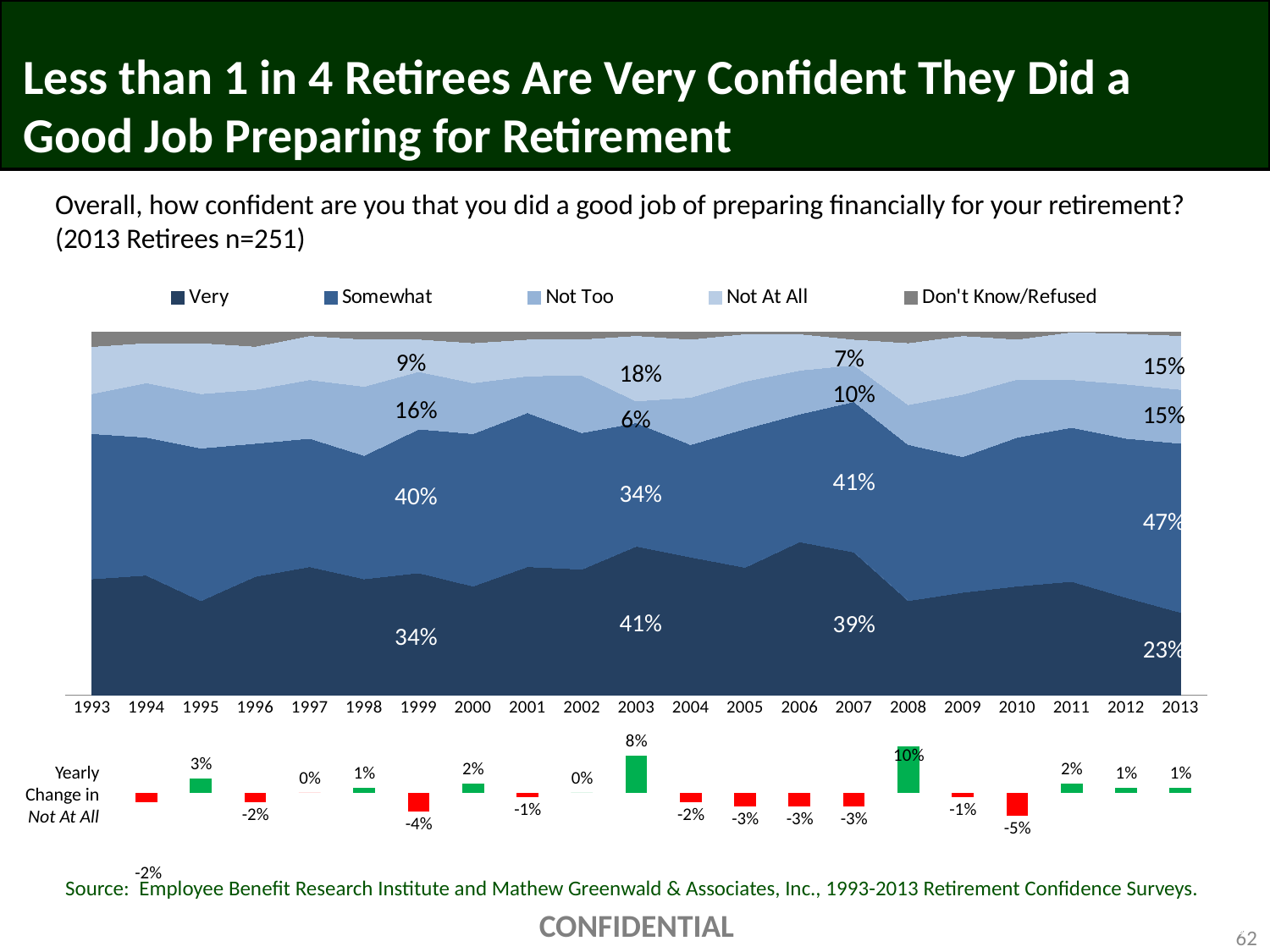
In the stacked area chart, what percentage of retirees were Somewhat confident in 1999? 40% In the stacked area chart, what percentage of retirees were Very confident in 2013? 23% What kind of chart is the Yearly Change in Not At All chart at the bottom of the slide? Bar chart In the stacked area chart, what percentage of retirees were Not Too confident in 2007? 10% In the Yearly Change in Not At All bar chart, which year shows the largest change? 2008 In the stacked area chart, what percentage of retirees were Not At All confident in 2003? 18% In the Yearly Change in Not At All bar chart, which year shows the lowest change? 2010 In the Yearly Change in Not At All bar chart, what is the value for 2003? 8% What is the first year shown on the x axis of the stacked area chart? 1993 In the stacked area chart, which was larger in 2003: the Very share or the Somewhat share? Very In the stacked area chart, what is the difference between the Somewhat and Very percentages in 2013? 24% In the stacked area chart, how many series does the legend list? 5